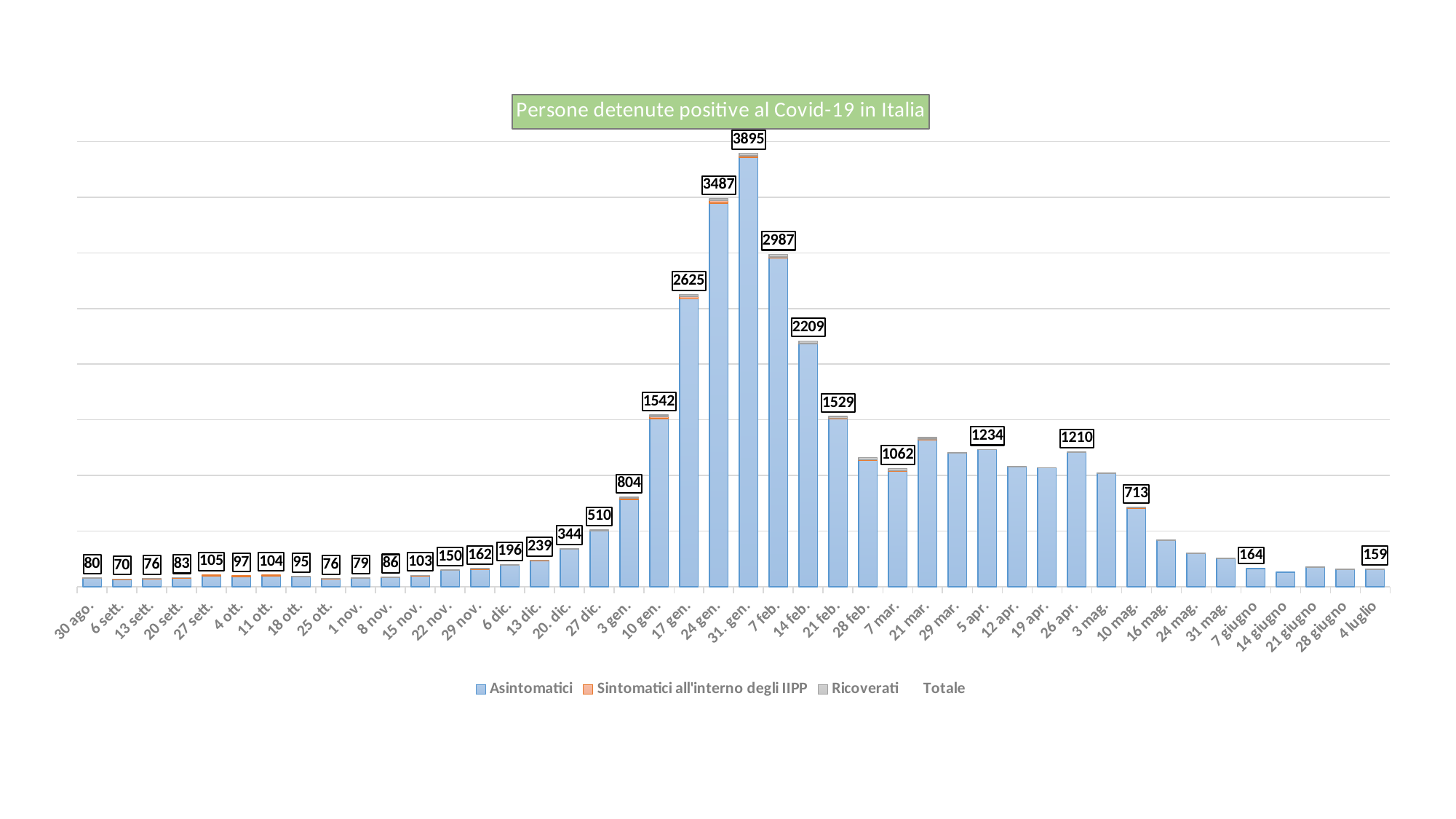
What kind of chart is shown on the slide? Stacked bar chart What is the title of the chart? Persone detenute positive al Covid-19 in Italia Which date has the lowest labelled total? 6 sett. What is the difference between the totals for 24 gen. and 7 feb.? 500 What is the total number of positive detainees on 31 gen.? 3895 What is the difference between the totals for 5 apr. and 26 apr.? 24 How many series does the legend list? 4 How many dates are shown on the x axis? 44 Which date has the highest total of positive detainees? 31 gen. What is the total value shown for 4 luglio? 159 Which is larger, the total for 17 gen. or the total for 14 feb.? 17 gen. What is the total value shown for 10 gen.? 1542